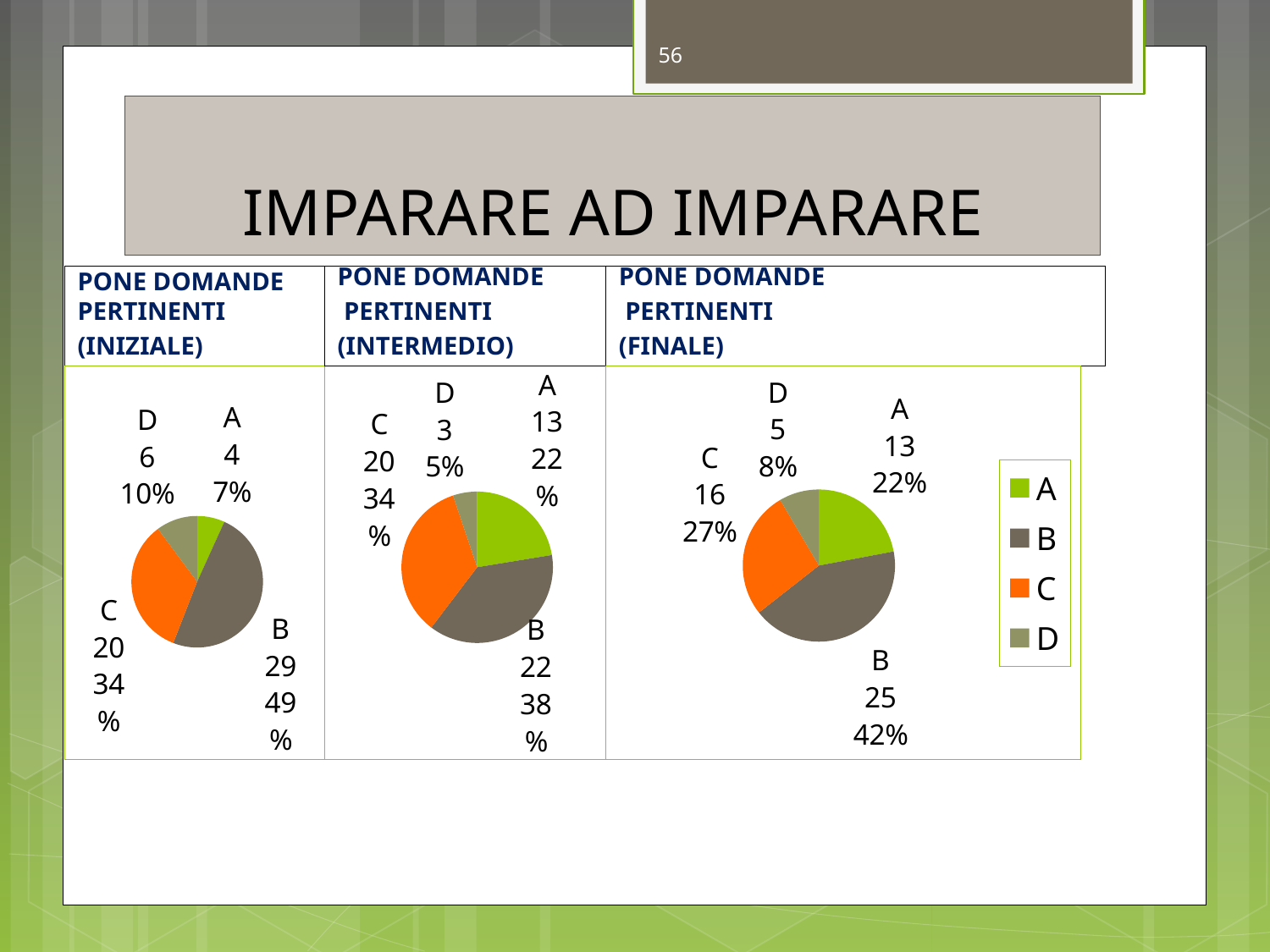
What kind of chart is used for PONE DOMANDE PERTINENTI (INIZIALE)? Pie chart In the PONE DOMANDE PERTINENTI (INIZIALE) chart, which category has the smallest slice? A In the PONE DOMANDE PERTINENTI (INIZIALE) chart, what percentage does slice B represent? 49% In the PONE DOMANDE PERTINENTI (FINALE) chart, what is the count shown for category B? 25 In the PONE DOMANDE PERTINENTI (INTERMEDIO) chart, what percentage does slice A represent? 22% In the PONE DOMANDE PERTINENTI (FINALE) chart, which is larger, the count for A or the count for D? A In the PONE DOMANDE PERTINENTI (INTERMEDIO) chart, what is the count shown for category D? 3 In the PONE DOMANDE PERTINENTI (FINALE) chart, what is the difference between the counts for B and C? 9 In the PONE DOMANDE PERTINENTI (INTERMEDIO) chart, which category has the largest slice? B In the PONE DOMANDE PERTINENTI (INIZIALE) chart, what is the count shown for category C? 20 How many entries does the legend on the right of the slide list? 4 In the PONE DOMANDE PERTINENTI (FINALE) chart, what percentage does slice C represent? 27%